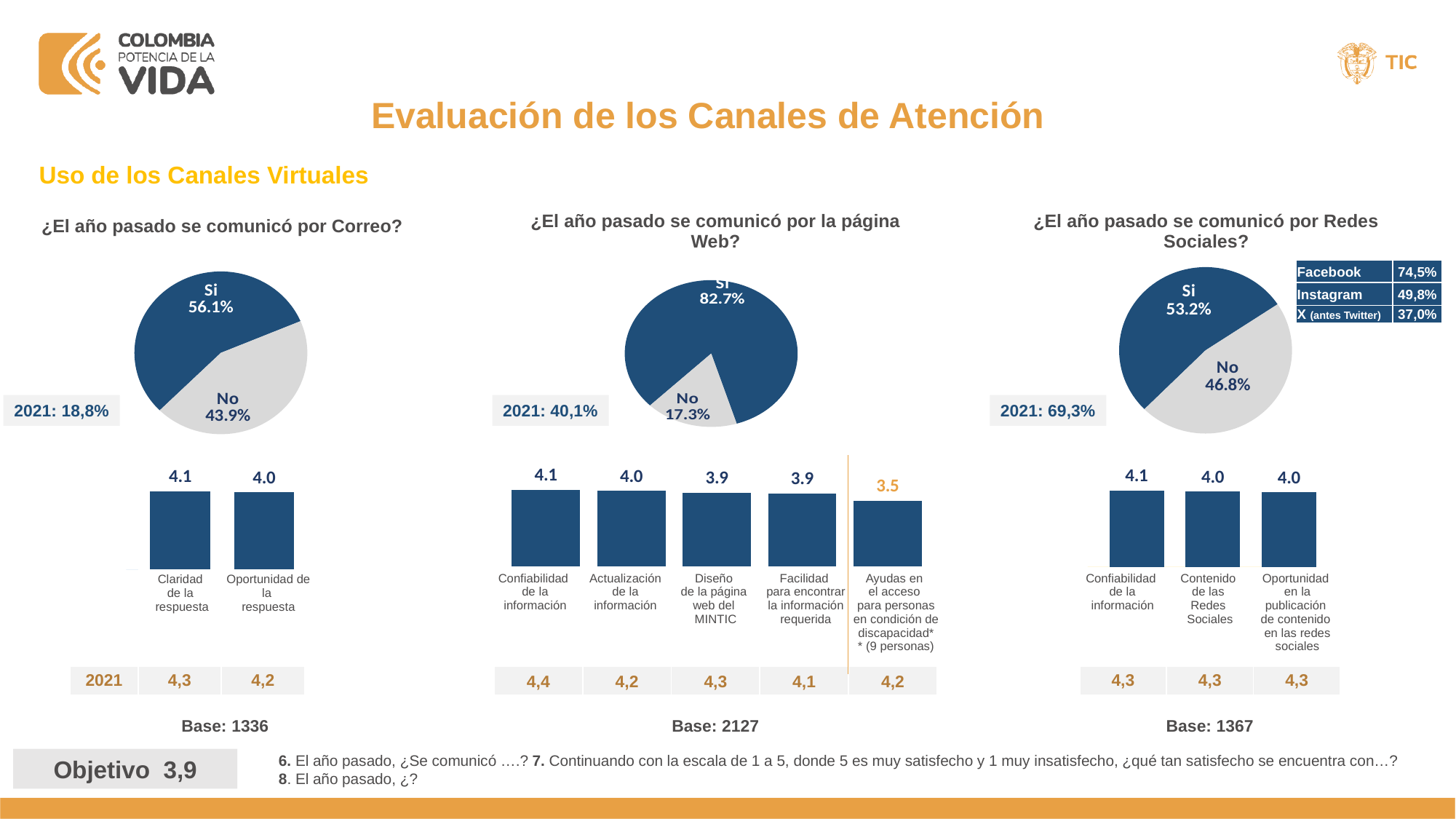
In the pie chart '¿El año pasado se comunicó por Redes Sociales?', what is the value for 'Si'? 53.2% In the bar chart below the 'Correo' pie chart, what is the value for 'Claridad de la respuesta'? 4.1 What kind of chart is '¿El año pasado se comunicó por Redes Sociales?'? pie chart In the bar chart below the 'Redes Sociales' pie chart, what is the value for 'Contenido de las Redes Sociales'? 4.0 In the pie chart '¿El año pasado se comunicó por Correo?', what is the difference between 'Si' and 'No'? 12.2% In the pie chart '¿El año pasado se comunicó por Correo?', what is the value for 'Si'? 56.1% In the bar chart below the 'página Web' pie chart, which category has the lowest value? Ayudas en el acceso para personas en condición de discapacidad How many bars are in the bar chart below the 'página Web' pie chart? 5 In the bar chart below the 'página Web' pie chart, which category has the highest value? Confiabilidad de la información In the pie chart '¿El año pasado se comunicó por la página Web?', which slice is larger, 'Si' or 'No'? Si In the pie chart '¿El año pasado se comunicó por la página Web?', what is the value for 'No'? 17.3% In the bar chart below the 'página Web' pie chart, what is the value for 'Ayudas en el acceso para personas en condición de discapacidad'? 3.5